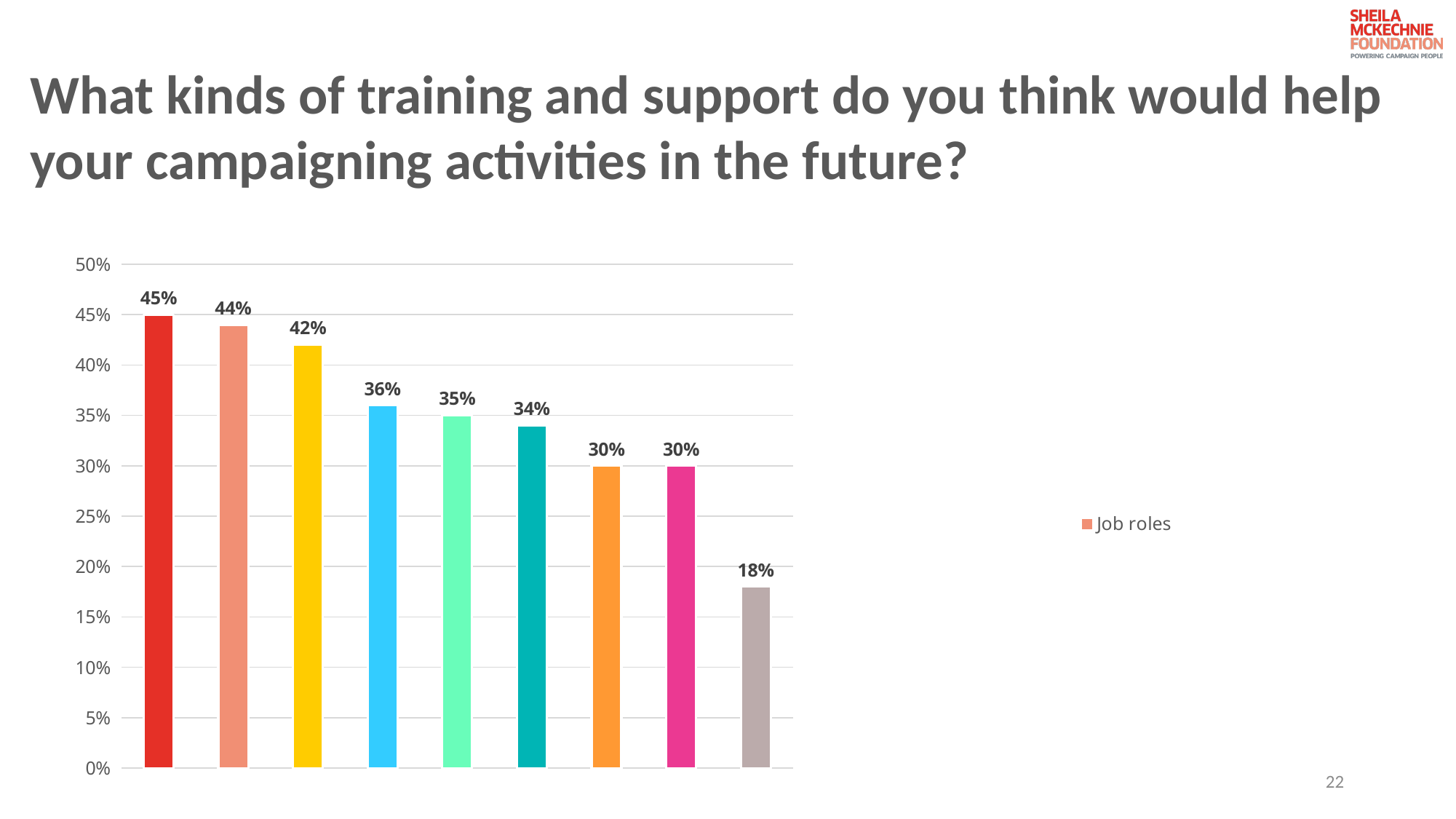
How many series does the legend list? 1 What is the difference between the first bar (45%) and the last bar (18%)? 27% Is the value of the grey bar (last on the right) greater or less than 20%? less What is the value of the tallest bar in the chart? 45% What is the value shown on the light blue bar (fourth from the left)? 36% What is the value of the shortest bar in the chart? 18% Which is larger, the value of the teal bar (sixth from the left) or the orange bar (seventh from the left)? the teal bar (34%) What type of chart is shown on the slide? bar chart What is the legend entry shown on the slide? Job roles What is the value shown on the yellow bar (third from the left)? 42% Do the bar values rise or fall from left to right across the chart? fall How many bars are plotted in the chart? 9